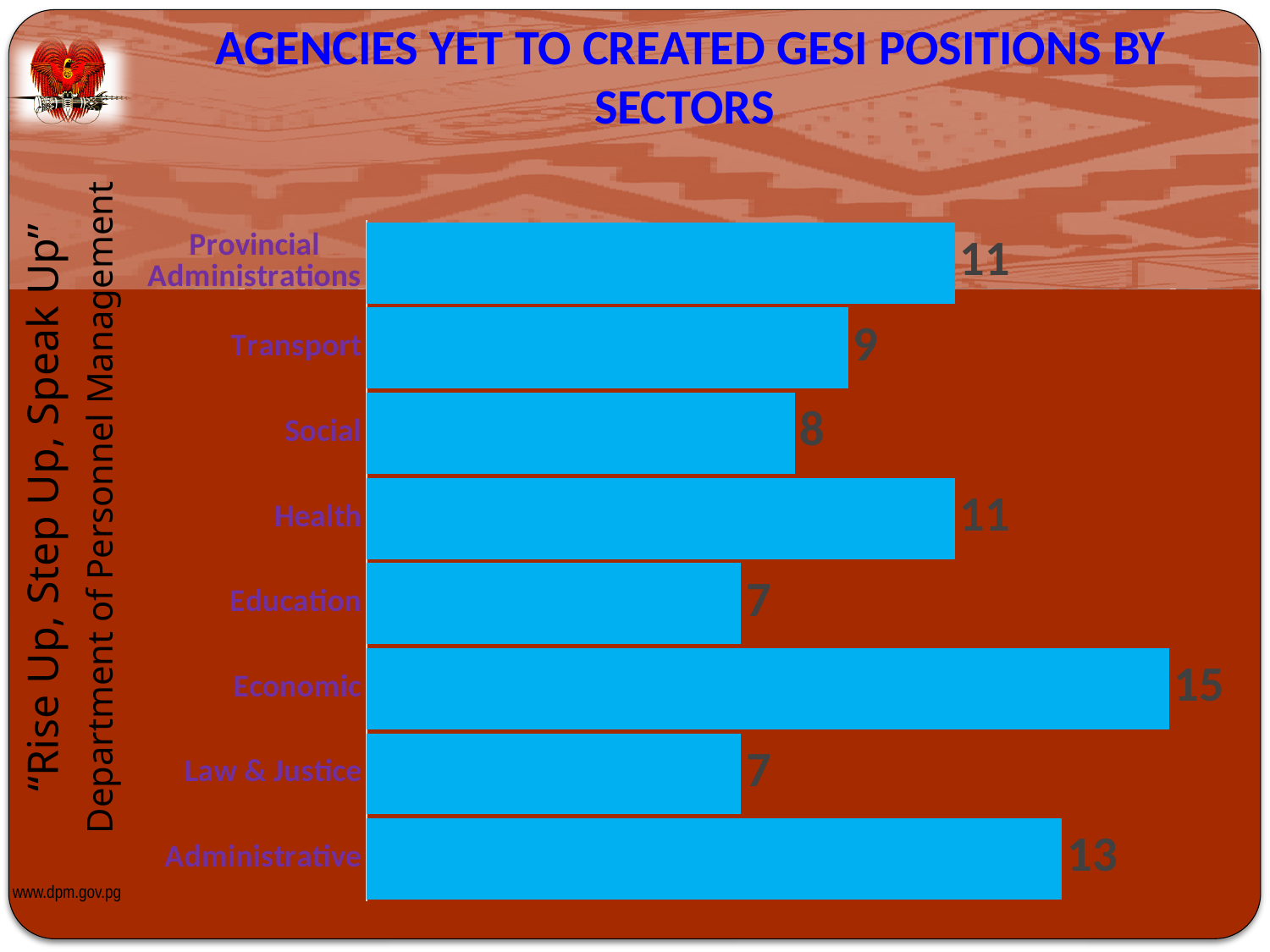
How many sectors are shown in the chart? 8 What kind of chart is shown on the slide? Bar chart Which sector has the highest value? Economic Which is larger, the value for Transport or the value for Education? Transport What is the value for Transport? 9 What is the title of the chart? AGENCIES YET TO CREATED GESI POSITIONS BY SECTORS What is the value for Provincial Administrations? 11 What is the value for the Economic sector? 15 What is the difference between the values for Health and Social? 3 What is the value for Administrative? 13 Which sectors share the lowest value of 7? Education and Law & Justice What is the difference between the values for Economic and Administrative? 2